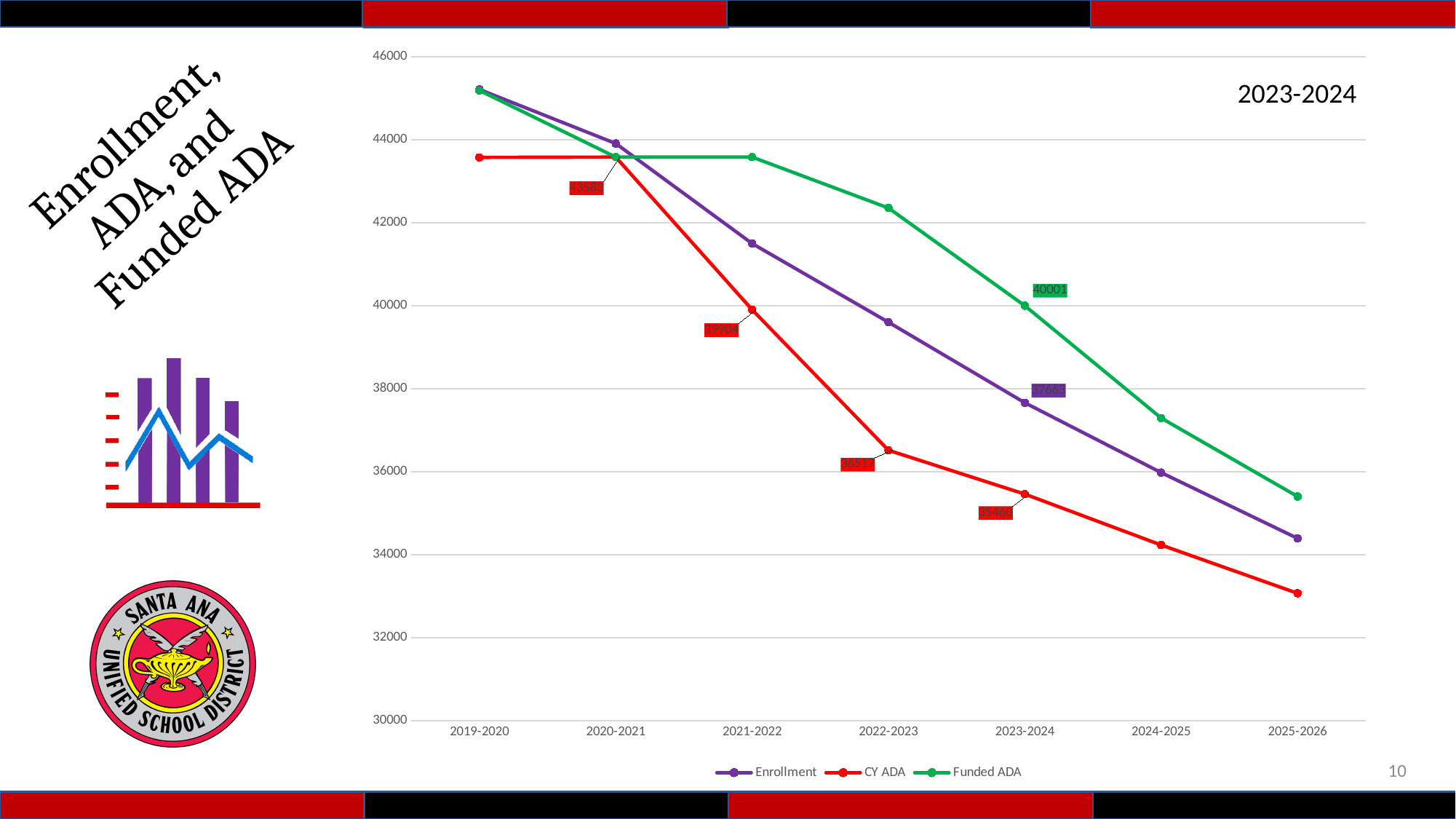
What is the CY ADA value for 2021-2022? 39904 What is the CY ADA value for 2023-2024? 35460 What is the difference between Funded ADA and CY ADA in 2023-2024? 4541 What is the Funded ADA value for 2023-2024? 40001 Is the Enrollment value for 2025-2026 greater or less than 36000? less Does the Enrollment line rise or fall from 2019-2020 to 2025-2026? fall What is the CY ADA value for 2022-2023? 36517 How many series does the chart legend list? 3 What kind of chart is shown on the slide? line chart By how much did CY ADA fall from 2020-2021 to 2021-2022? 3679 What is the CY ADA value for 2020-2021? 43583 How many school years are plotted along the x axis? 7